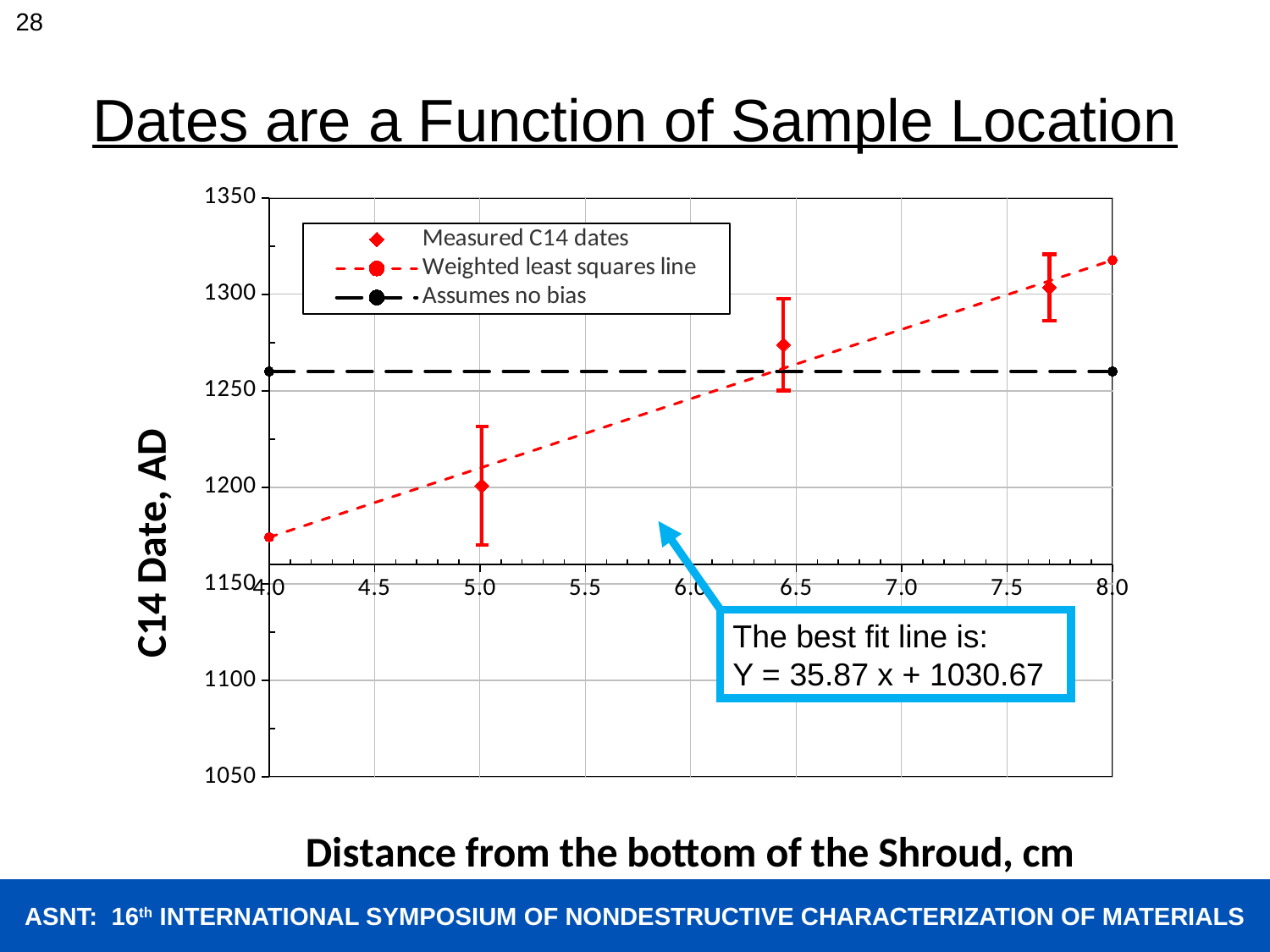
Do the measured C14 dates rise or fall as the distance from the bottom of the Shroud increases? Rise Is the rightmost measured C14 date greater or less than 1250? greater Is the middle measured C14 date greater or less than 1300? less Which measured C14 date point is the highest: the leftmost, middle, or rightmost? Rightmost What is the label of the x axis? Distance from the bottom of the Shroud, cm Which is larger, the leftmost measured C14 date or the middle measured C14 date? The middle measured C14 date How many measured C14 date points are plotted? 3 What kind of chart is shown on the slide? Scatter chart with lines Is the leftmost measured C14 date greater or less than 1250? less Which measured C14 date point is the lowest: the leftmost, middle, or rightmost? Leftmost What is the equation of the best fit line given on the slide? Y = 35.87 x + 1030.67 How many series does the legend list? 3